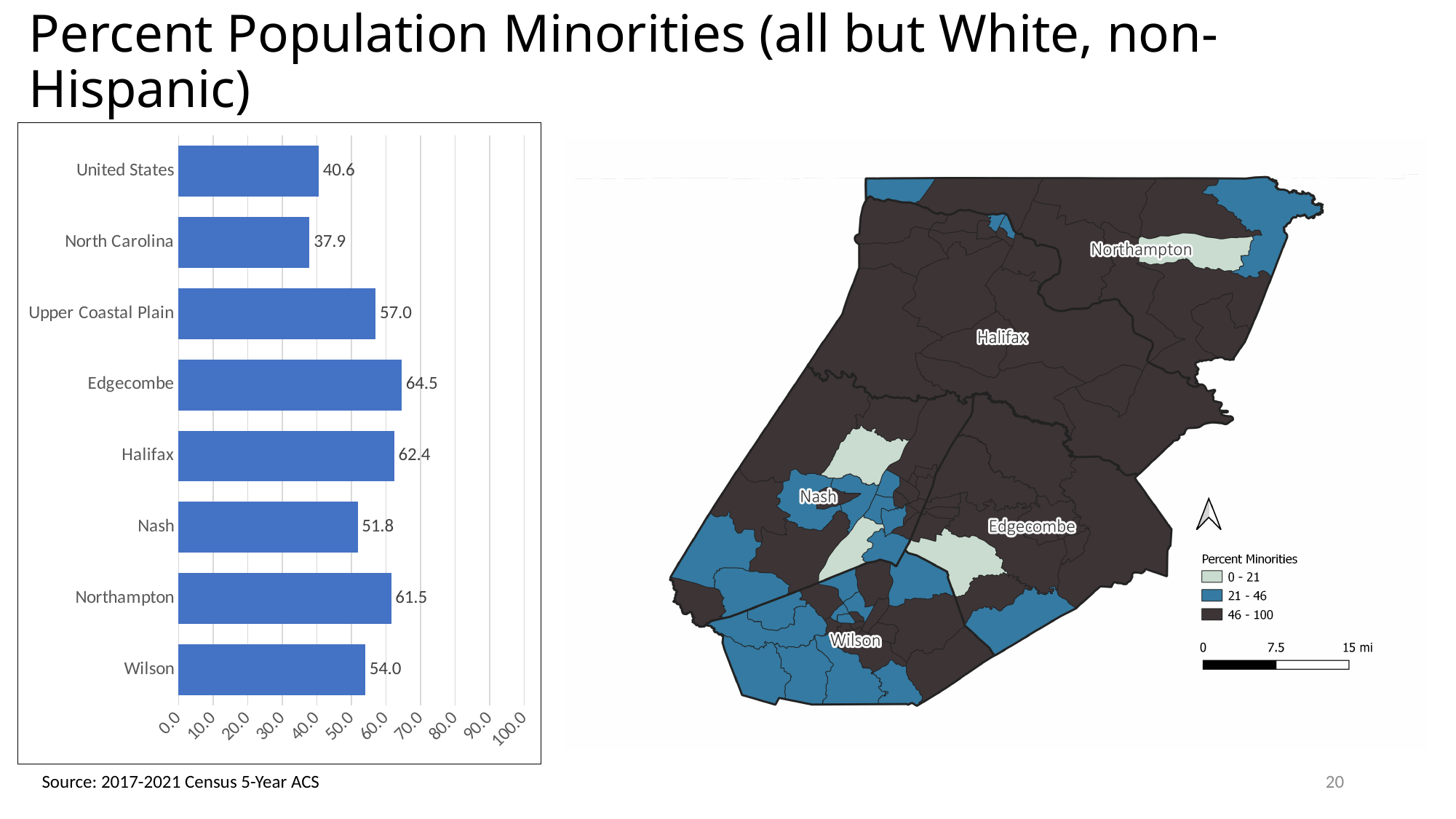
Which category has the lowest value in the bar chart? North Carolina What is the difference between the values for Edgecombe and Nash in the bar chart? 12.7 What kind of chart is shown on the left of the slide? bar chart Is the value for Wilson in the bar chart greater or less than 50.0? greater How many categories are shown in the bar chart? 8 What is the value for Edgecombe in the bar chart? 64.5 What is the difference between the values for United States and North Carolina in the bar chart? 2.7 What is the value for Upper Coastal Plain in the bar chart? 57.0 Which category has the highest value in the bar chart? Edgecombe Which has a larger value in the bar chart, Halifax or Northampton? Halifax What is the value for North Carolina in the bar chart? 37.9 How many classes does the map legend 'Percent Minorities' list? 3